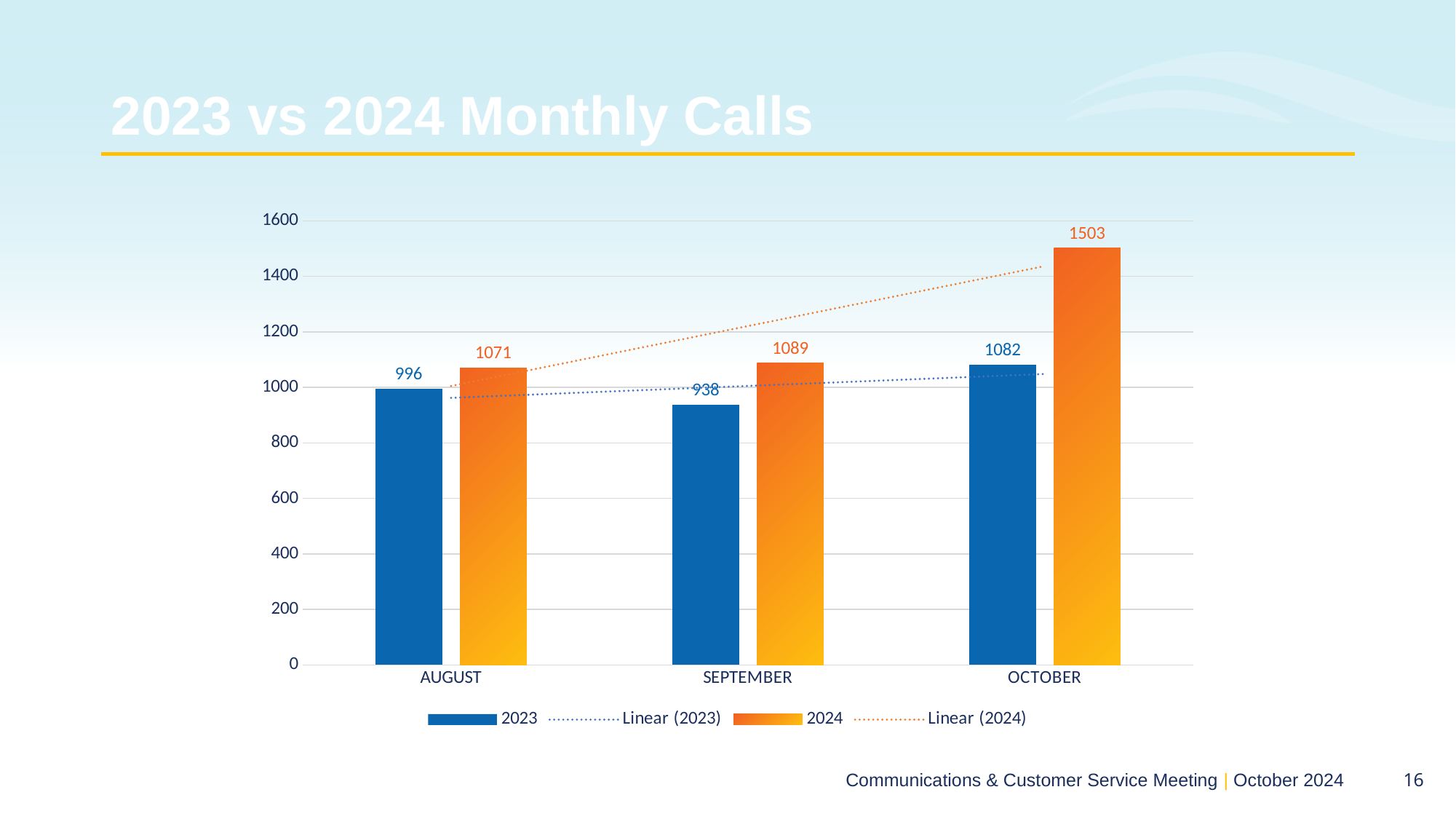
How many months are shown on the x axis? 3 Which month has the highest value for 2024? October What kind of chart is shown on the slide? Bar chart How many entries does the legend list? 4 What is the value for 2024 in October? 1503 Which month has the lowest value for 2023? September What is the value for 2024 in September? 1089 Which is larger in August, the 2023 value or the 2024 value? 2024 What is the value for 2023 in September? 938 Do the 2024 values rise or fall from August to October? Rise What is the difference between the 2024 and 2023 values in October? 421 What is the value for 2023 in August? 996